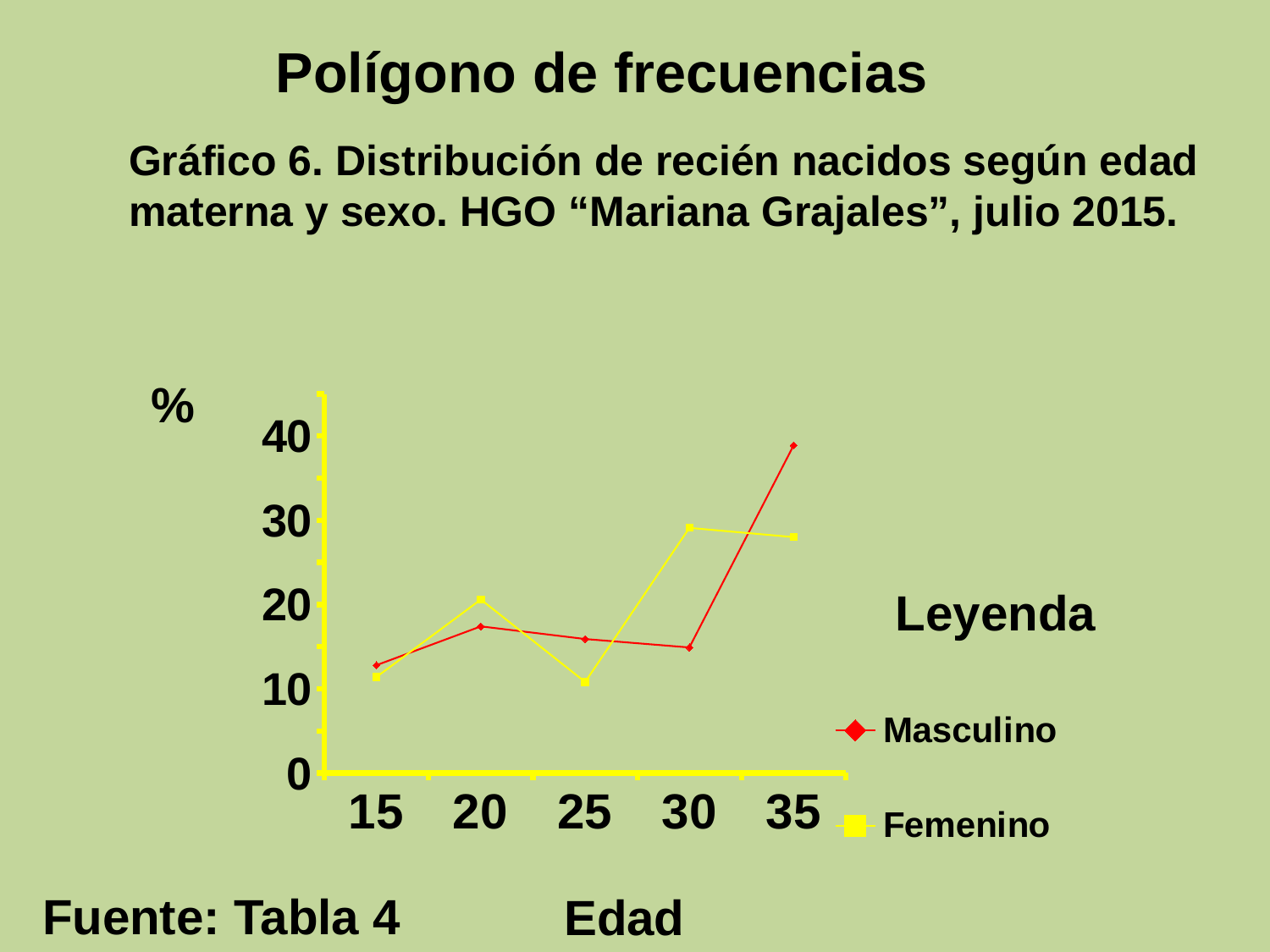
How many age categories are plotted along the x axis? 5 At age 35, which series has the larger value, Masculino or Femenino? Masculino Is the Masculino value at age 35 greater or less than 30? greater How many series does the legend list? 2 What kind of chart is shown on the slide? line chart Is the Masculino value at age 30 greater or less than 20? less Is the Femenino value at age 25 greater or less than 20? less Does the Masculino series rise or fall between age 30 and age 35? rise At age 30, which series has the larger value, Masculino or Femenino? Femenino What label is given to the x axis of the chart? Edad At which age is the Masculino series highest? 35